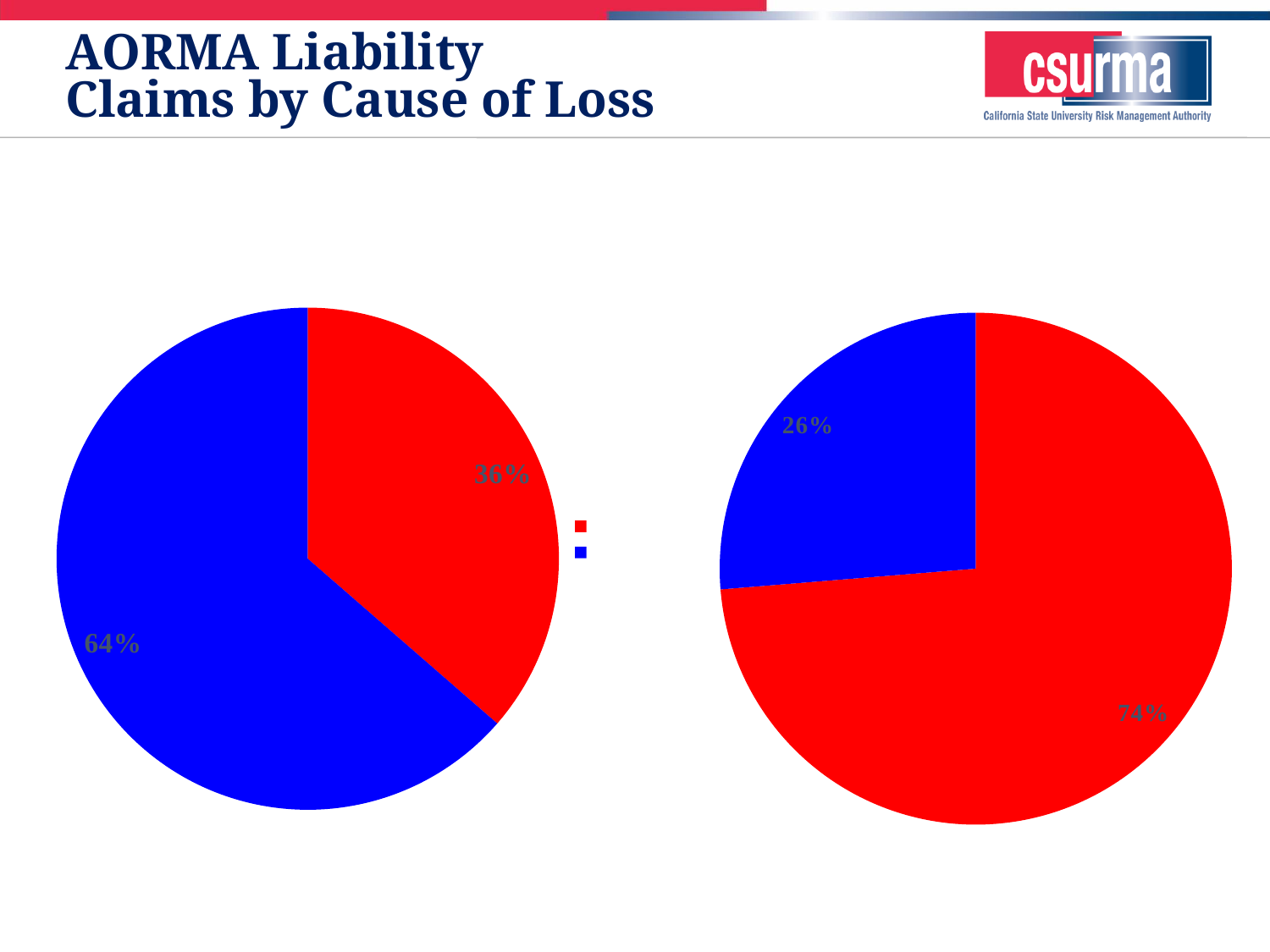
What kind of chart is the right chart on the slide? pie chart In the right pie chart, what is the difference in percentage points between the red slice and the blue slice? 48 In the right pie chart, what percentage is shown for the red slice? 74% In the left pie chart, what is the difference in percentage points between the blue slice and the red slice? 28 In the left pie chart, what percentage is shown for the blue slice? 64% How many slices does the right pie chart have? 2 In the right pie chart, which colour slice is the smallest? blue What kind of chart is the left chart on the slide? pie chart In the left pie chart, what percentage is shown for the red slice? 36% In the right pie chart, what percentage is shown for the blue slice? 26% How many entries does the legend between the two pie charts list? 2 In the left pie chart, which colour slice is the largest? blue